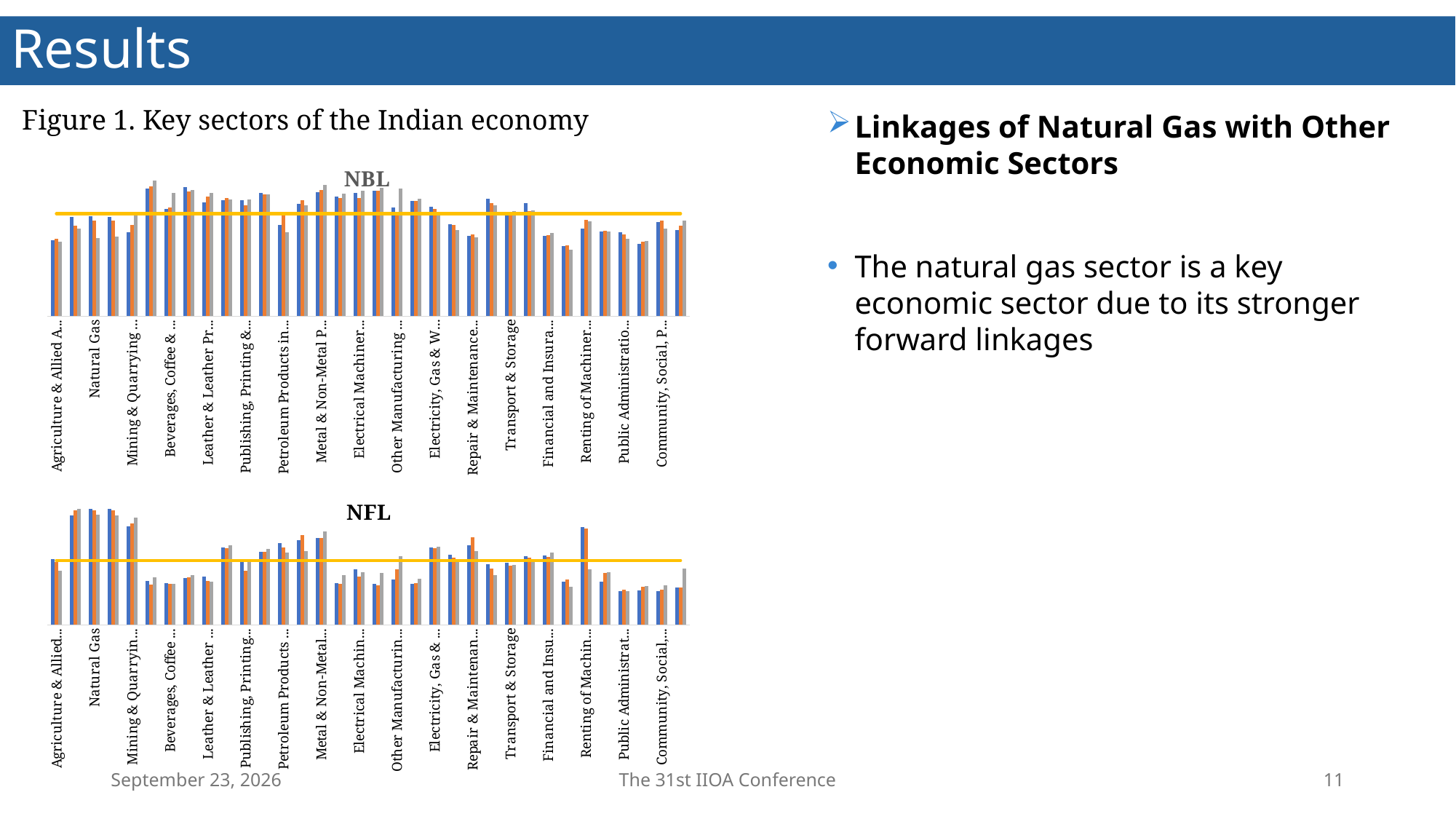
In the NFL chart, which is larger, the value for Natural Gas or the value for Agriculture & Allied? Natural Gas What kind of chart is the NBL chart? combination bar and line chart In the NFL chart, which labelled sector has the highest values? Natural Gas In the NFL chart, which is larger, the value for Natural Gas or the value for Public Administration? Natural Gas What kind of chart is the NFL chart? combination bar and line chart What is the figure caption above the charts? Figure 1. Key sectors of the Indian economy In the NFL chart, which is larger, the value for Mining & Quarrying or the value for Beverages, Coffee? Mining & Quarrying What is the title of the upper chart on the slide? NBL